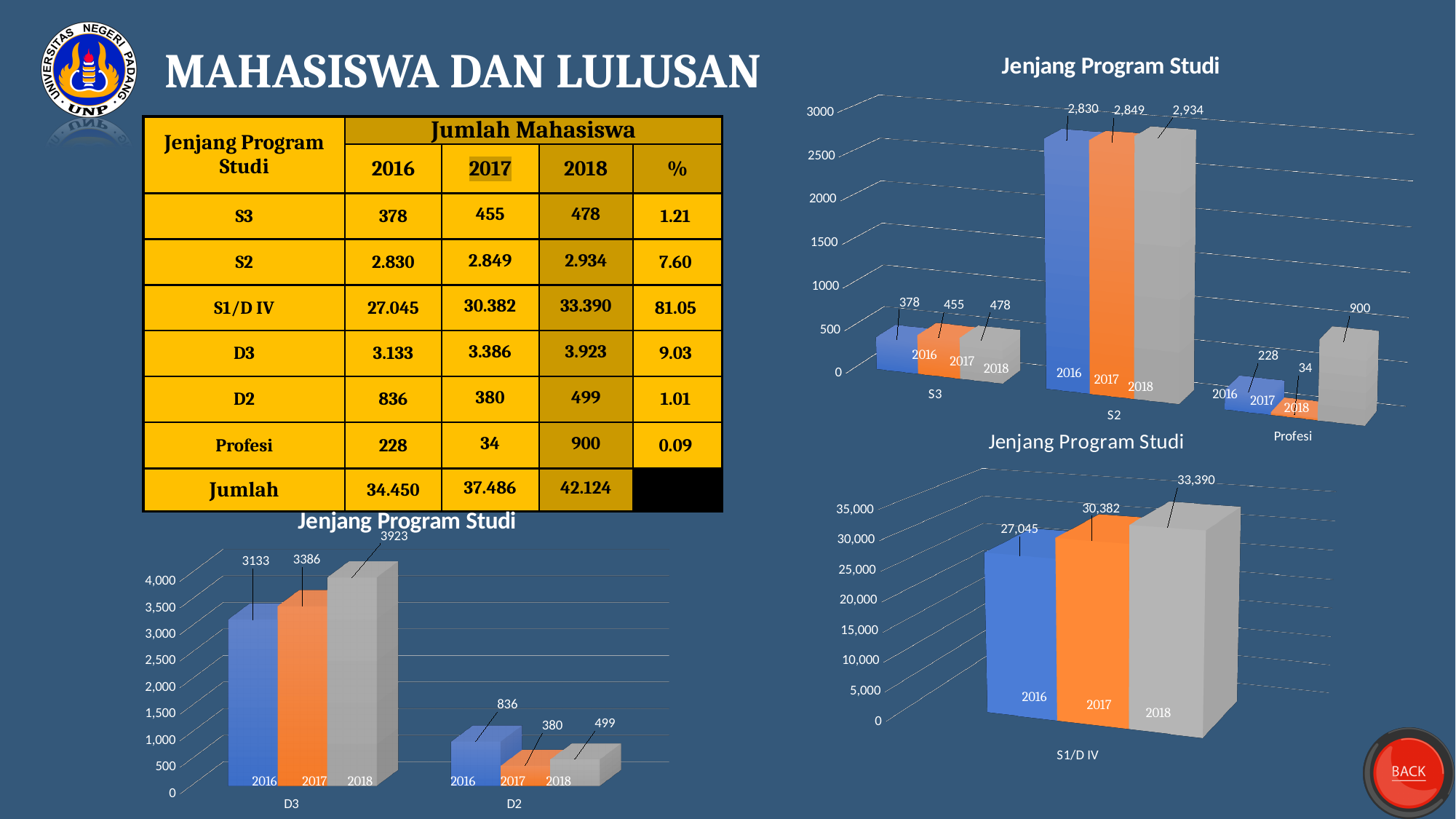
In the top-right chart, which is larger: the 2016 value for S3 or the 2016 value for Profesi? S3 (378) In the bottom-left chart, which year has the highest value for D2? 2016 How many categories are shown on the x axis of the bottom-left chart? 2 In the bottom-right chart, what is the difference between the 2018 and 2016 values for S1/D IV? 6,345 In the top-right chart, what is the value for S2 in 2018? 2,934 In the bottom-right chart, do the values for S1/D IV rise or fall from 2016 to 2018? rise In the top-right chart, what is the value for Profesi in 2017? 34 What kind of chart is the top-right chart? bar chart In the bottom-left chart, what is the value for D3 in 2016? 3133 In the top-right chart, which year has the lowest value for Profesi? 2017 In the bottom-right chart, what is the value for S1/D IV in 2017? 30,382 In the bottom-left chart, what is the difference between the 2018 and 2017 values for D3? 537